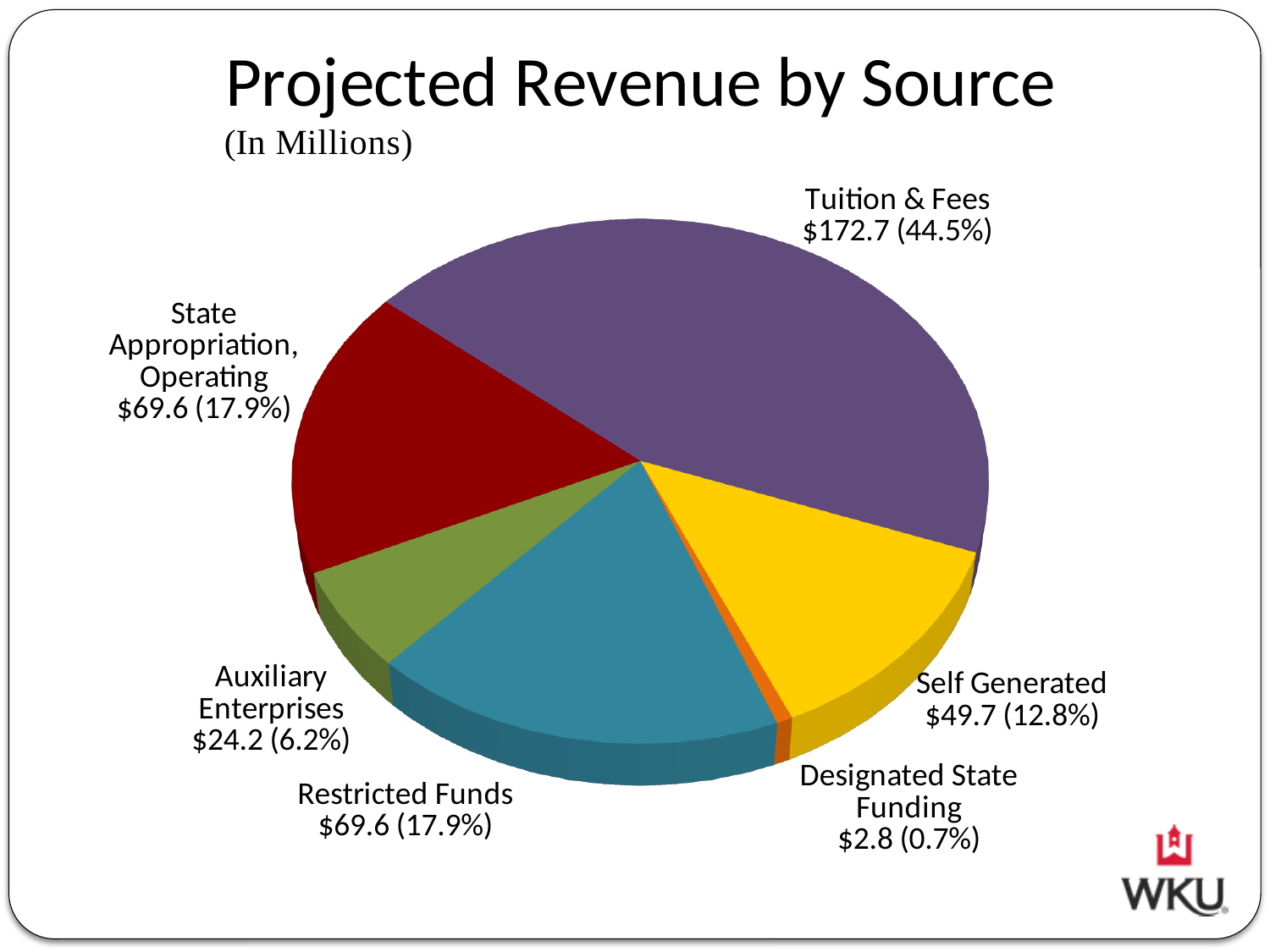
What share of projected revenue comes from Designated State Funding? 0.7% What type of chart is shown on the slide? Pie chart Which is larger, the revenue from Self Generated sources or from Auxiliary Enterprises? Self Generated What share of projected revenue comes from Restricted Funds? 17.9% What is the projected revenue from Tuition & Fees? $172.7 What is the projected revenue from Self Generated sources? $49.7 What is the difference between the Tuition & Fees revenue and the Self Generated revenue? $123.0 What is the projected revenue from Auxiliary Enterprises? $24.2 Which revenue source has the smallest slice of the pie? Designated State Funding How many revenue sources are shown in the pie chart? 6 Which revenue source has the largest slice of the pie? Tuition & Fees In what units are the values in the chart expressed? In Millions